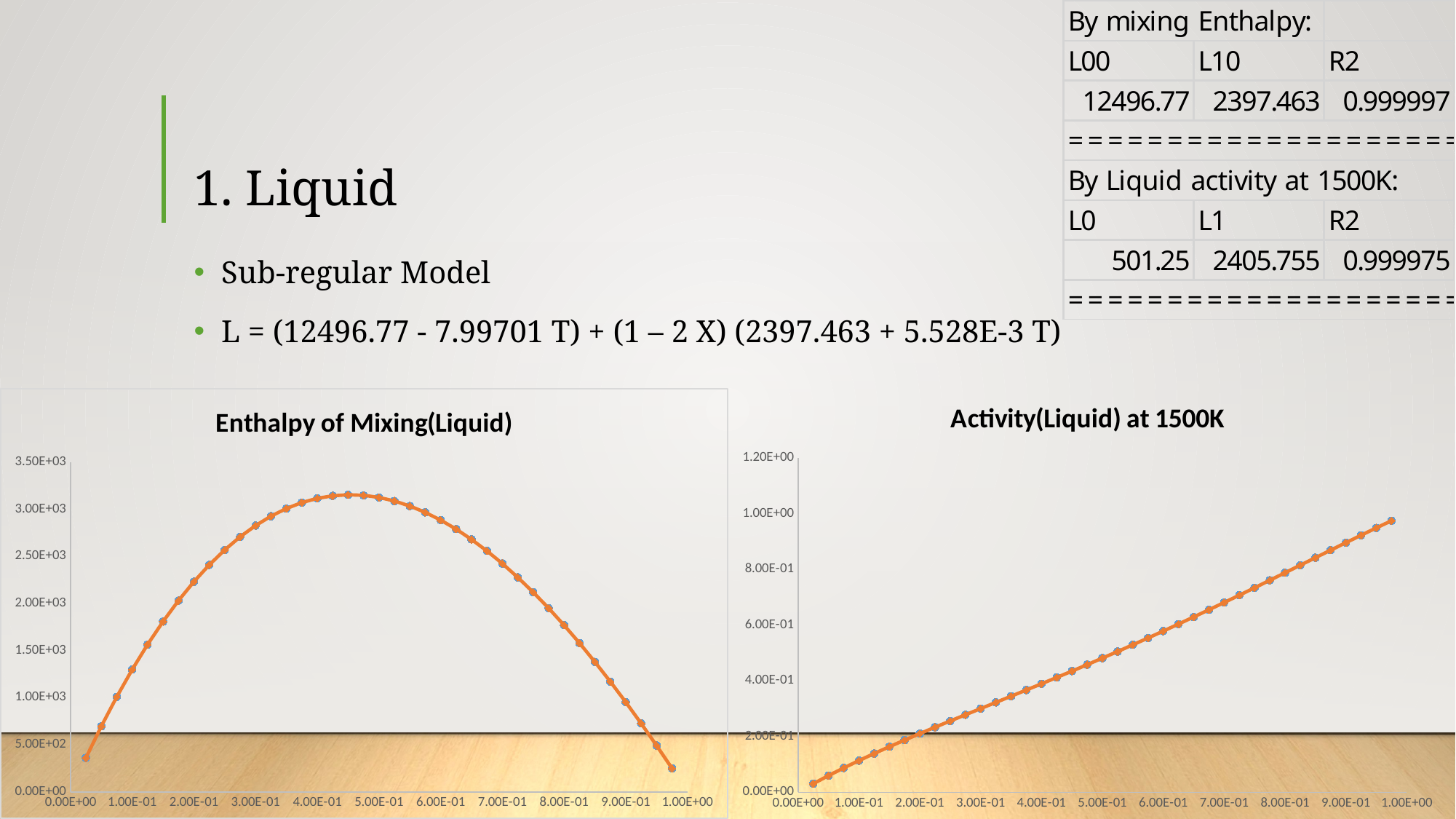
In the "Activity(Liquid) at 1500K" chart, do the values rise or fall as x increases? rise In the "Enthalpy of Mixing(Liquid)" chart, which is larger: the value at x = 4.00E-01 or the value at x = 9.00E-01? the value at x = 4.00E-01 What kind of chart is the "Activity(Liquid) at 1500K" chart? line chart with markers In the "Activity(Liquid) at 1500K" chart, is the value at x = 9.00E-01 greater or less than 8.00E-01? greater What is the title of the chart on the right side of the slide? Activity(Liquid) at 1500K In the "Enthalpy of Mixing(Liquid)" chart, is the value at x = 5.00E-01 greater or less than 2.50E+03? greater In the "Activity(Liquid) at 1500K" chart, is the value at x = 2.00E-01 greater or less than 4.00E-01? less What kind of chart is the "Enthalpy of Mixing(Liquid)" chart? line chart with markers In the "Enthalpy of Mixing(Liquid)" chart, how do the values change as x increases from 0 to 1? rise then fall What is the title of the chart on the left side of the slide? Enthalpy of Mixing(Liquid)